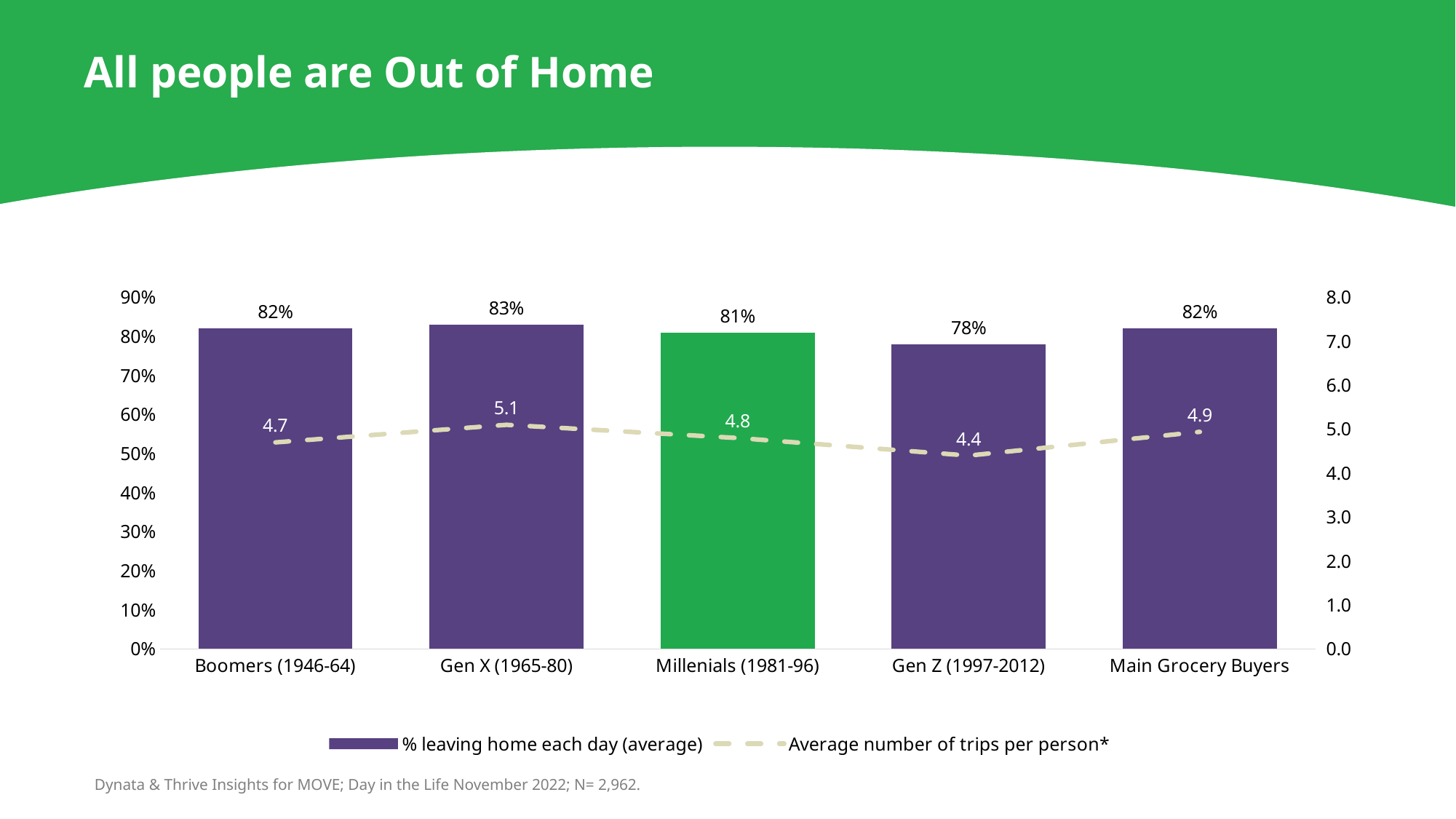
What kind of chart is shown on the slide? Combined bar and line chart Which category has the highest % leaving home each day (average)? Gen X (1965-80) Which category has the lowest average number of trips per person? Gen Z (1997-2012) How many categories are shown on the x axis? 5 What is the average number of trips per person for Main Grocery Buyers? 4.9 Which has a higher average number of trips per person, Boomers (1946-64) or Millenials (1981-96)? Millenials (1981-96) What is the % leaving home each day (average) for Gen Z (1997-2012)? 78% What is the difference in % leaving home each day between Gen X (1965-80) and Gen Z (1997-2012)? 5% How many series does the legend list? 2 What is the average number of trips per person for Gen X (1965-80)? 5.1 What is the % leaving home each day (average) for Millenials (1981-96)? 81% Which category's bar is coloured green rather than purple? Millenials (1981-96)